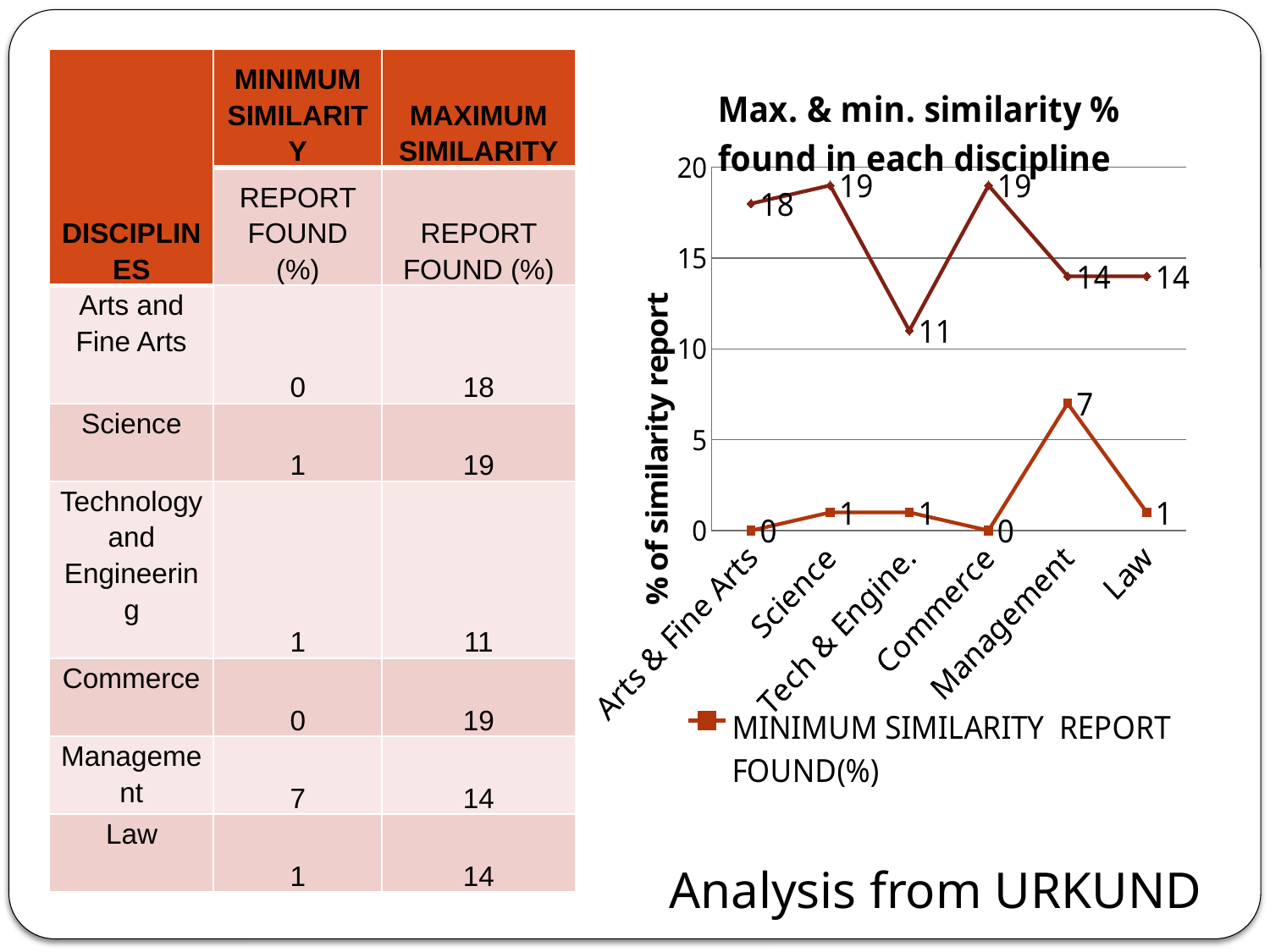
Which discipline has the highest minimum similarity % in the chart? Management What is the minimum similarity % found for Management in the chart? 7 Which has a higher maximum similarity % in the chart, Science or Law? Science Which discipline has the lowest maximum similarity % in the chart? Tech & Engine. Is the maximum similarity % for Arts & Fine Arts greater or less than 15? greater How many disciplines are shown on the x axis of the chart? 6 What is the maximum similarity % found for Commerce in the chart? 19 What is the maximum similarity % found for Tech & Engine. in the chart? 11 What is the title of the y axis of the chart? % of similarity report What is the difference between the maximum and minimum similarity % for Management in the chart? 7 What kind of chart is shown on the slide? line chart Does the minimum similarity line rise or fall from Commerce to Management? rise